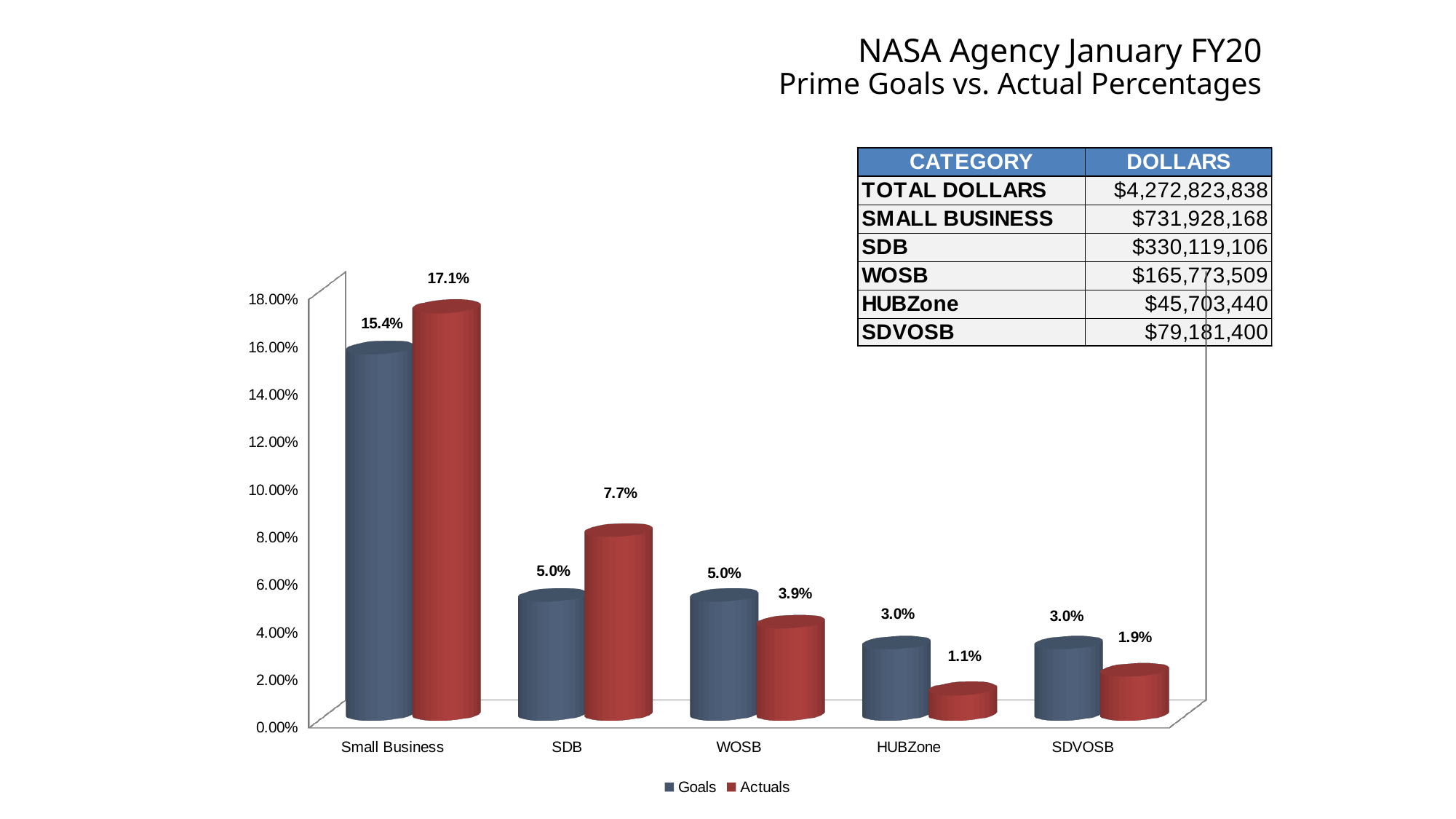
How many categories are shown on the x axis? 5 What is the title of the chart? NASA Agency January FY20 Prime Goals vs. Actual Percentages What is the Actuals value for Small Business? 17.1% Which category has the highest Actuals value? Small Business What is the difference between the Goals and Actuals values for WOSB? 1.1% What kind of chart is shown on the slide? Bar chart What is the Actuals value for HUBZone? 1.1% Which is larger for SDVOSB, the Goals value or the Actuals value? Goals What is the Goals value for SDB? 5.0% What is the difference between the Actuals and Goals values for SDB? 2.7% Which category has the lowest Actuals value? HUBZone How many series does the legend list? 2